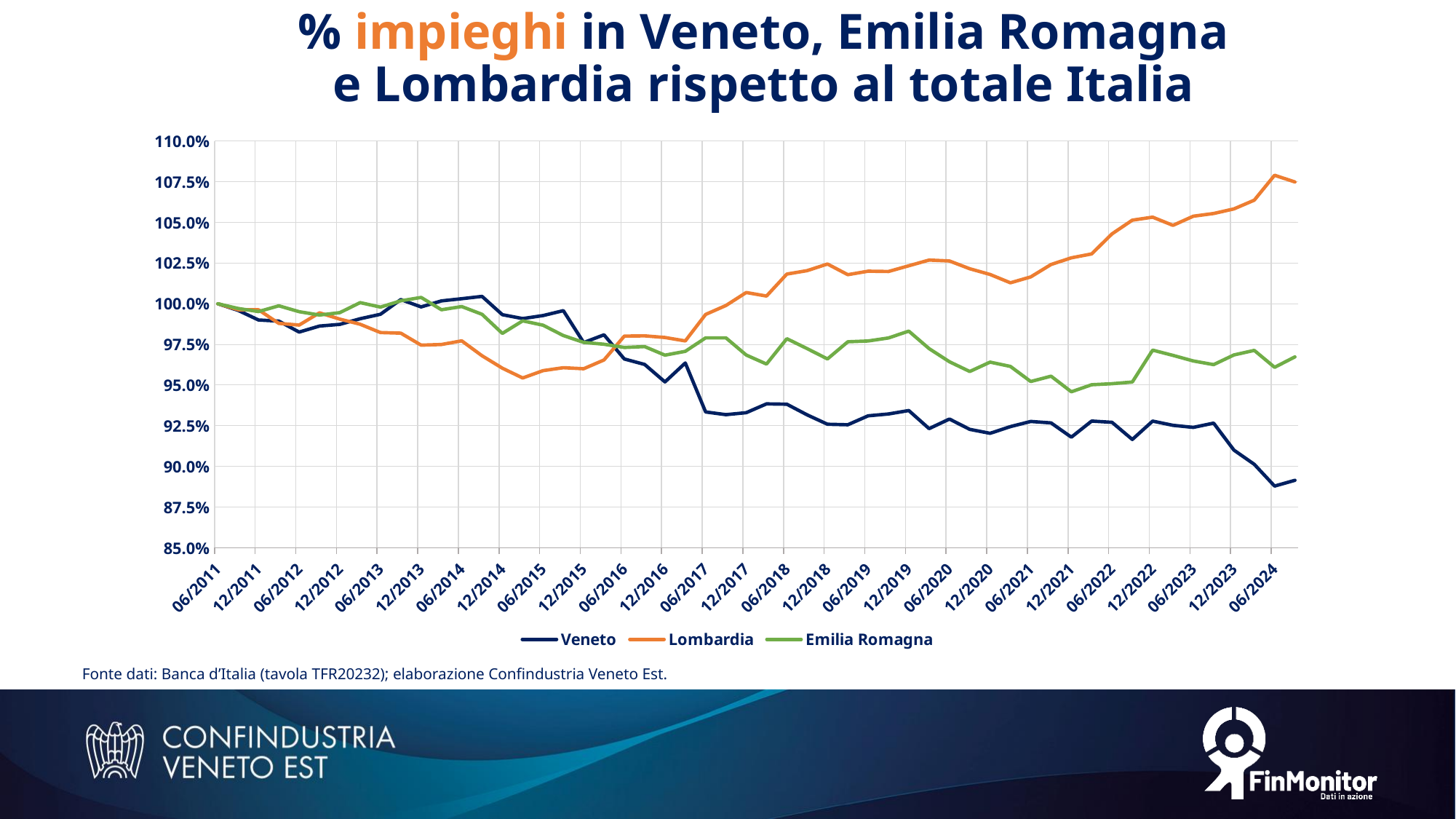
Does the Veneto line rise or fall from 06/2011 to 06/2024? fall Which series has the highest value at 06/2024? Lombardia What is the value for Veneto at 06/2011? 100.0% At 06/2024, which is larger: the value for Lombardia or the value for Veneto? Lombardia Is the value for Lombardia at 06/2024 greater or less than 105.0%? greater Which series has the lowest value at 06/2024? Veneto Is the value for Emilia Romagna at 06/2024 greater or less than 100.0%? less What kind of chart is shown on the slide? line chart How many series does the legend list? 3 Does the Lombardia line rise or fall from 06/2011 to 06/2024? rise Which series are listed in the legend? Veneto, Lombardia, Emilia Romagna Is the value for Veneto at 06/2024 greater or less than 90.0%? less